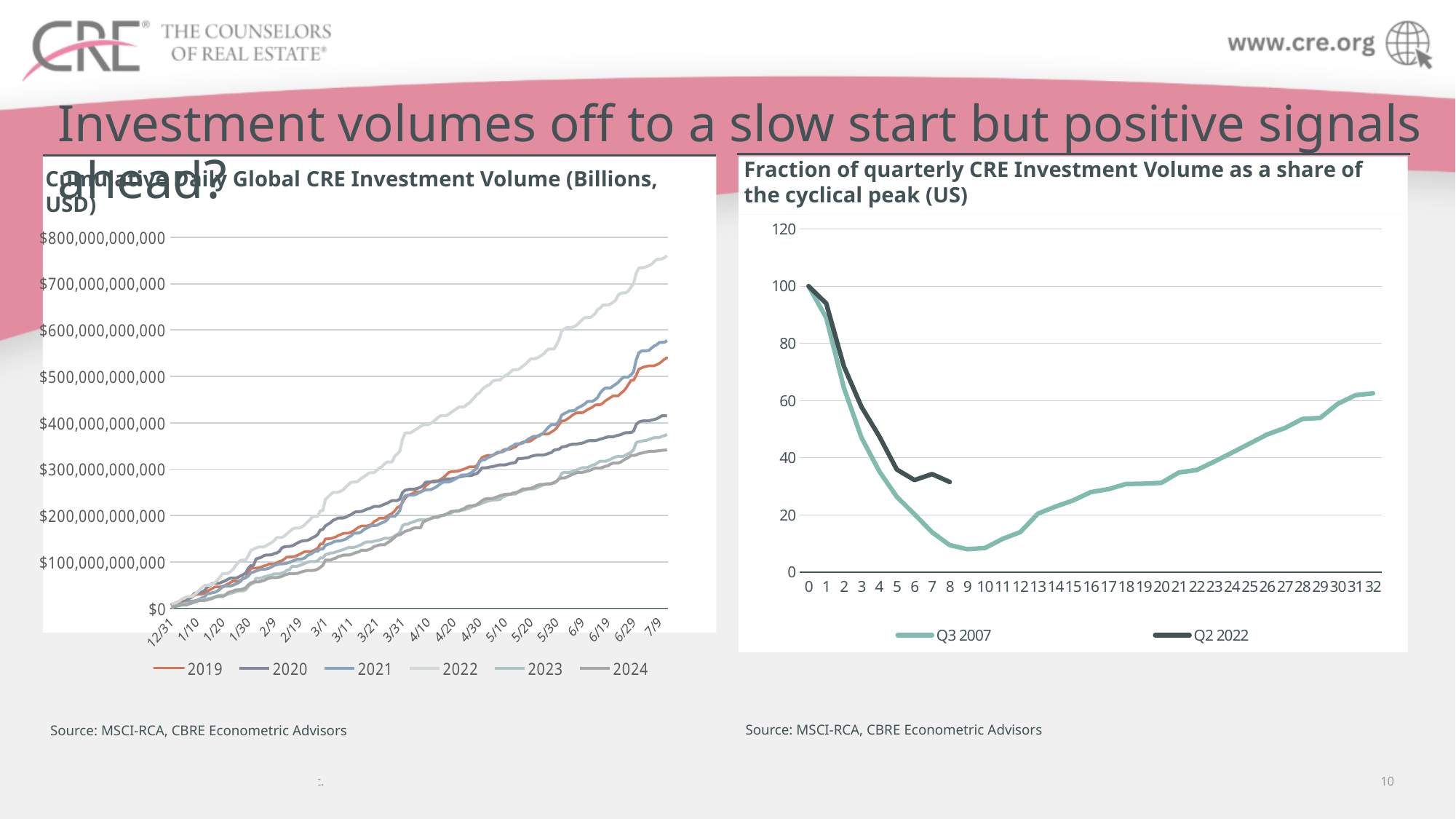
In the left chart, 'Cumulative Daily Global CRE Investment Volume', is the value for 2022 at 7/9 greater or less than $700,000,000,000? greater In the right chart, 'Fraction of quarterly CRE Investment Volume as a share of the cyclical peak (US)', is the lowest value of the Q3 2007 line greater or less than 20? less How many series does the legend of the left chart, 'Cumulative Daily Global CRE Investment Volume', list? 6 What kind of chart is the left chart, 'Cumulative Daily Global CRE Investment Volume (Billions, USD)'? Line chart How many series does the legend of the right chart, 'Fraction of quarterly CRE Investment Volume as a share of the cyclical peak (US)', list? 2 In the right chart, 'Fraction of quarterly CRE Investment Volume as a share of the cyclical peak (US)', what are the two legend entries? Q3 2007 and Q2 2022 In the right chart, 'Fraction of quarterly CRE Investment Volume as a share of the cyclical peak (US)', what is the value of both series at quarter 0? 100 In the left chart, 'Cumulative Daily Global CRE Investment Volume', is the value for 2024 at 7/9 greater or less than $400,000,000,000? less In the left chart, 'Cumulative Daily Global CRE Investment Volume', which is larger at 7/9: the 2021 line or the 2020 line? 2021 In the left chart, 'Cumulative Daily Global CRE Investment Volume', which year's line is highest at the end of the period (7/9)? 2022 In the left chart, 'Cumulative Daily Global CRE Investment Volume', do the lines rise or fall along the x axis? Rise In the left chart, 'Cumulative Daily Global CRE Investment Volume', which year's line is lowest at the end of the period (7/9)? 2024